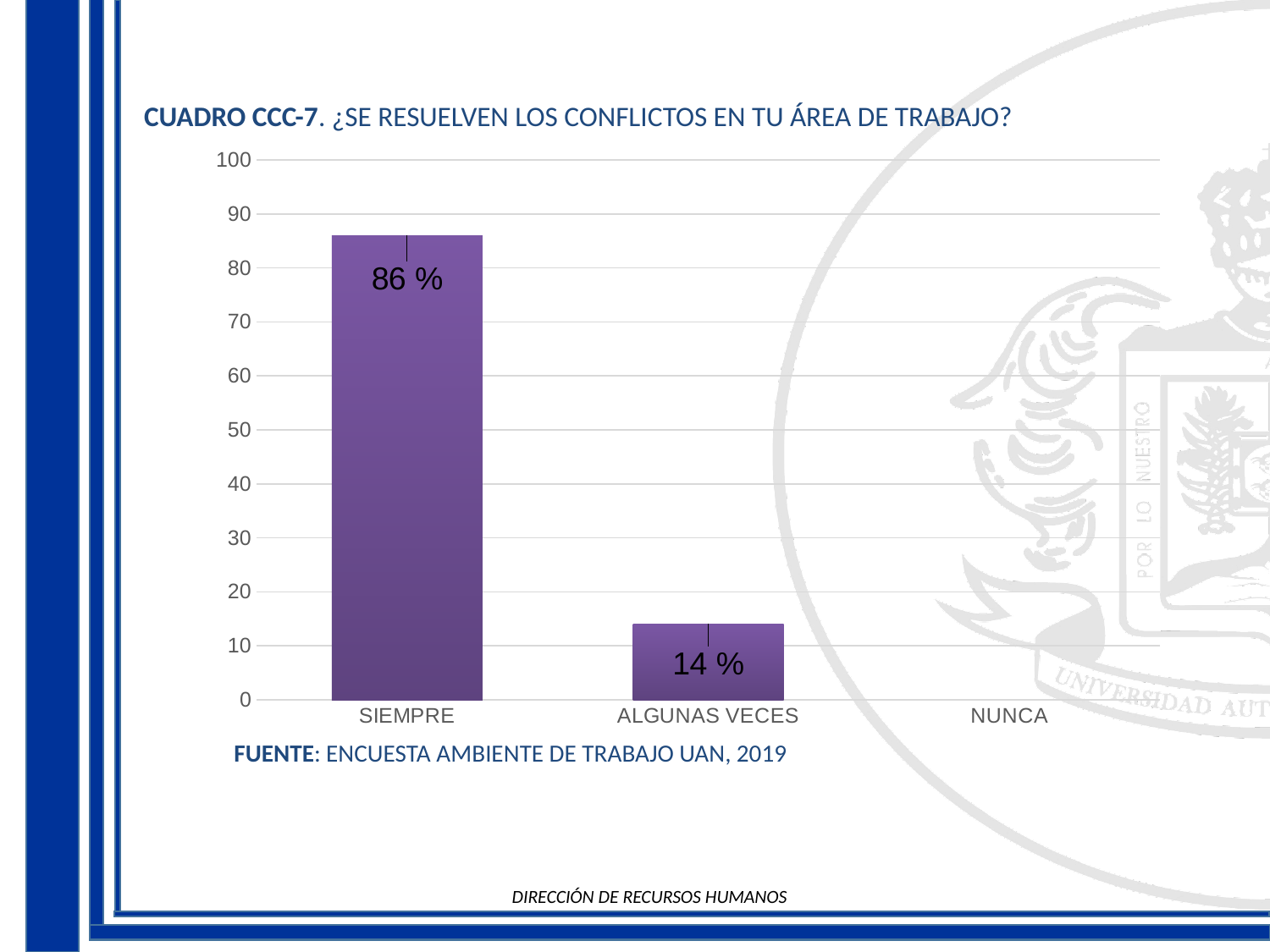
Do the values rise or fall from SIEMPRE to ALGUNAS VECES? fall Is the value for SIEMPRE greater or less than 80? greater What is the value for ALGUNAS VECES? 14 % Is the value for ALGUNAS VECES greater or less than 20? less How many categories are shown on the x axis? 3 What is the source cited below the chart? ENCUESTA AMBIENTE DE TRABAJO UAN, 2019 What is the value for SIEMPRE? 86 % What is the title of the chart? CUADRO CCC-7. ¿SE RESUELVEN LOS CONFLICTOS EN TU ÁREA DE TRABAJO? Which is larger, the value for SIEMPRE or the value for ALGUNAS VECES? SIEMPRE Which category has the highest value? SIEMPRE What kind of chart is shown on the slide? bar chart What is the difference between the values for SIEMPRE and ALGUNAS VECES? 72 %